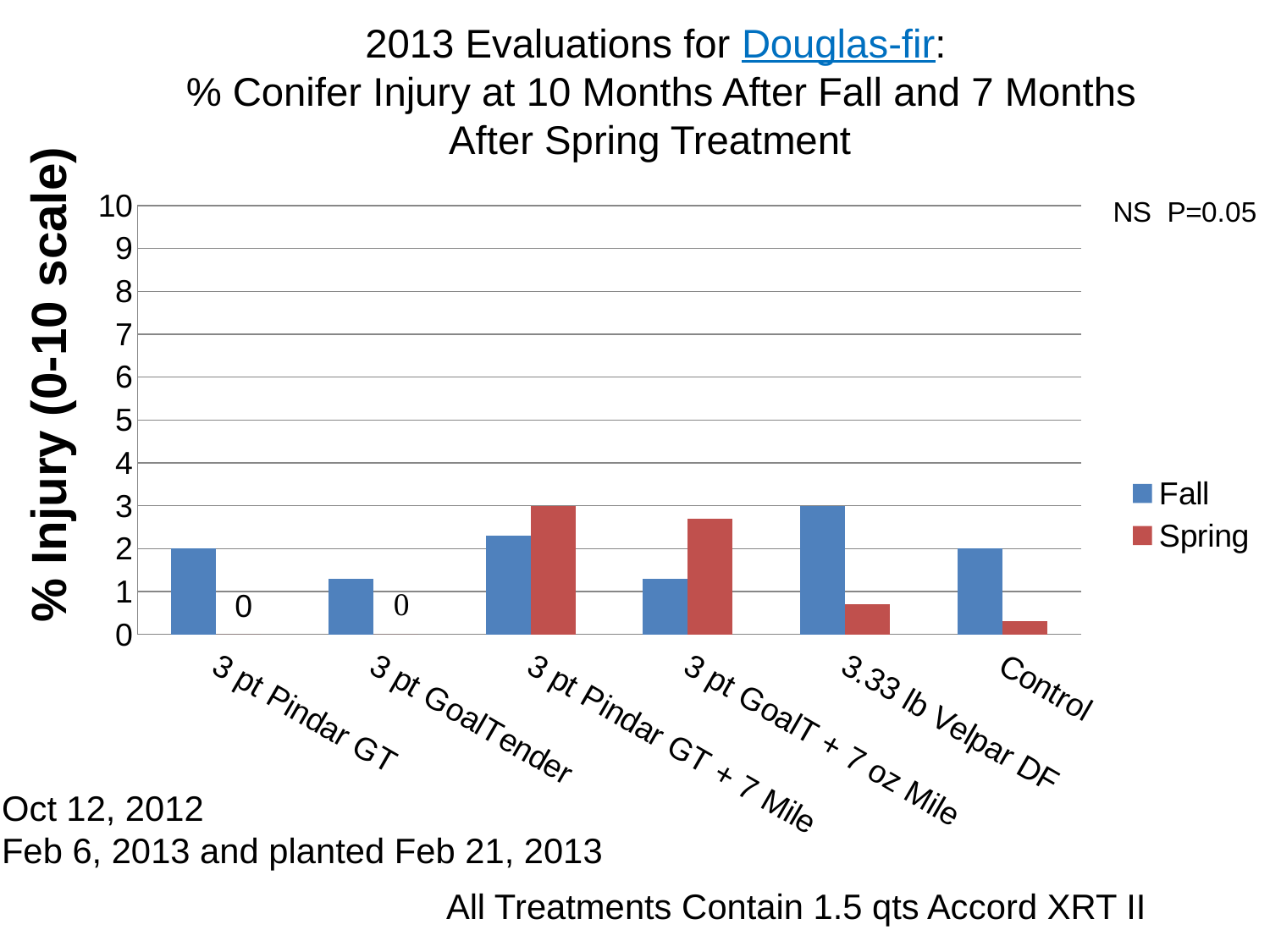
How many series does the legend list? 2 For 3 pt Pindar GT + 7 Mile, which is larger, the Fall value or the Spring value? Spring How many treatment categories are shown on the x axis? 6 What kind of chart is shown on the slide? bar chart Is the Fall value for 3 pt GoalTender greater or less than 2? less What are the two entries in the legend? Fall, Spring What is the Spring value for 3 pt GoalTender? 0 What is the Spring value for 3 pt Pindar GT? 0 Which treatment has the highest Fall value? 3.33 lb Velpar DF What is the Fall value for Control? 2 For Control, which is larger, the Fall value or the Spring value? Fall What is the Fall value for 3.33 lb Velpar DF? 3